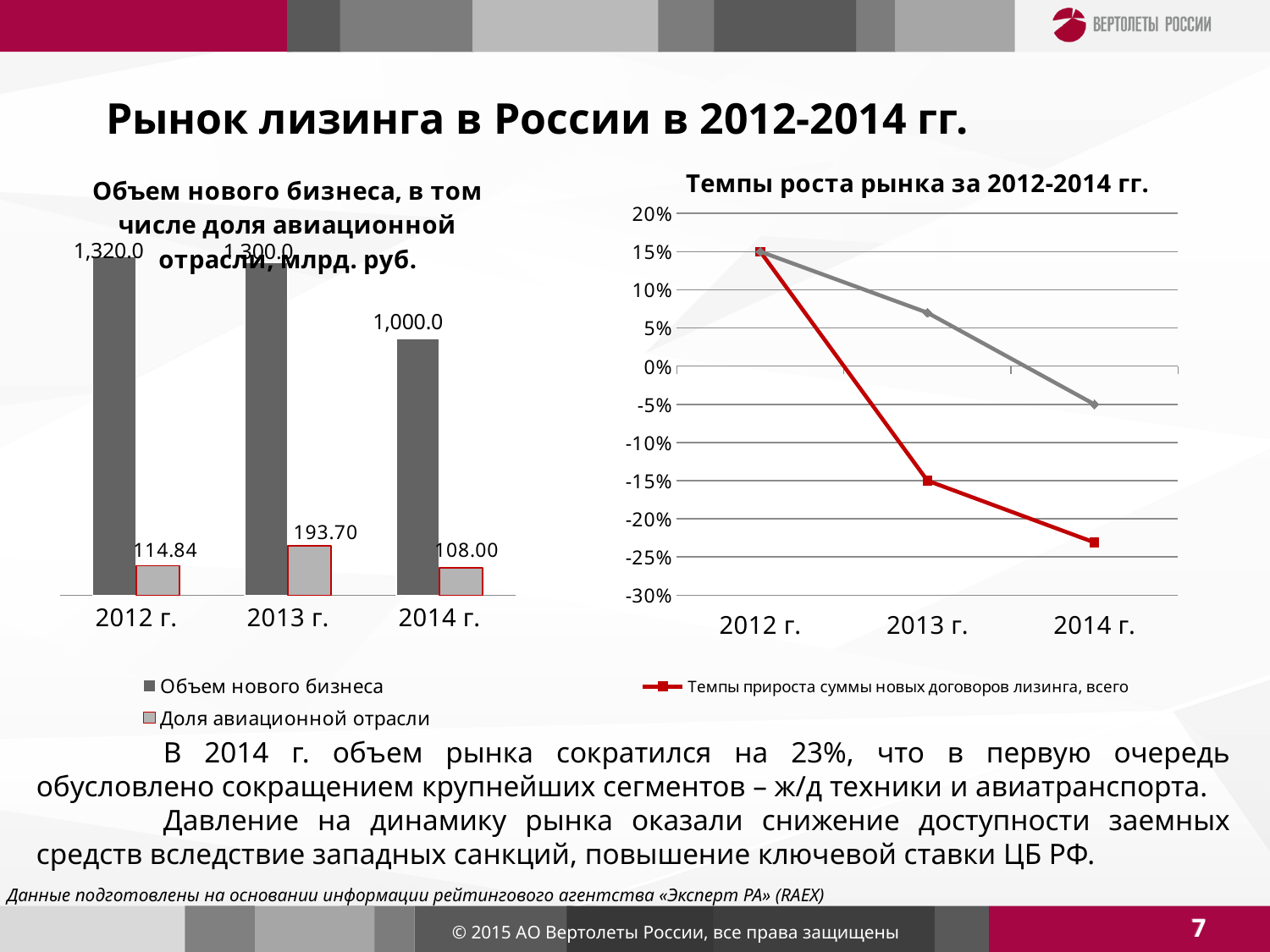
What kind of chart is the chart titled 'Темпы роста рынка за 2012-2014 гг.'? line chart In the left chart, which year has the highest value of Объем нового бизнеса? 2012 г. In the left chart, what is the difference between Объем нового бизнеса in 2012 г. and 2014 г.? 320.0 In the left chart, what is the value of Доля авиационной отрасли for 2013 г.? 193.70 In the left chart, what is the value of Объем нового бизнеса for 2013 г.? 1,300.0 In the left chart, which year has the lowest value of Доля авиационной отрасли? 2014 г. In the right chart, is the value of Темпы прироста суммы новых договоров лизинга, всего for 2014 г. greater or less than -20%? less In the right chart, does the red line (Темпы прироста суммы новых договоров лизинга, всего) rise or fall from 2012 г. to 2014 г.? fall How many years are shown on the x axis of the right chart? 3 How many series does the legend of the left chart list? 2 In the left chart, what is the value of Доля авиационной отрасли for 2014 г.? 108.00 In the left chart, is Доля авиационной отрасли larger in 2012 г. or in 2013 г.? 2013 г.